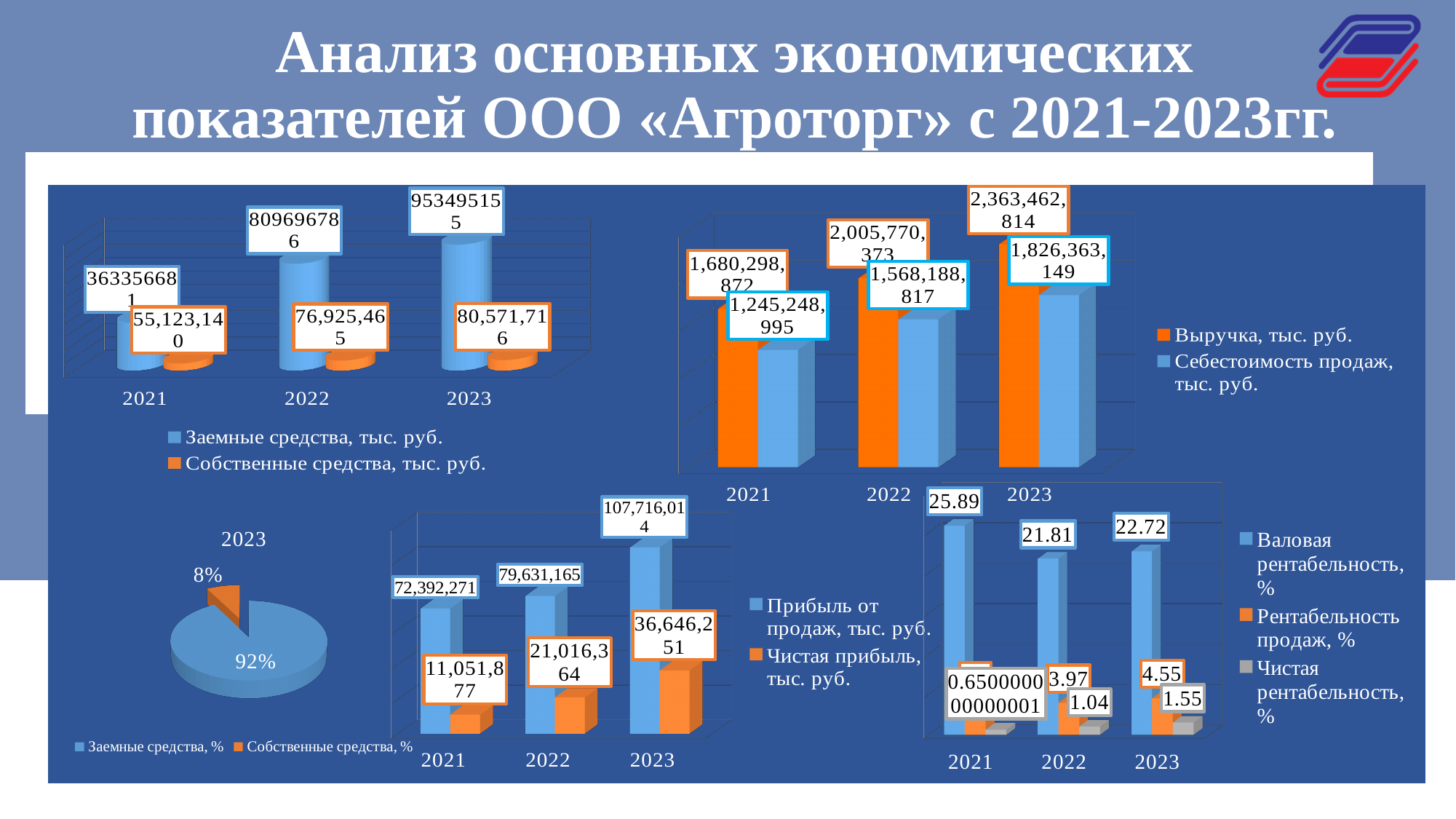
In the bottom-right chart, what is the value of Валовая рентабельность, % for 2021? 25.89 In the top-left chart, what is the value of Собственные средства, тыс. руб. for 2022? 76,925,465 In the bottom-middle chart, which year has the lowest Прибыль от продаж, тыс. руб.? 2021 In the top-right chart, which year has the highest Выручка, тыс. руб.? 2023 In the top-right chart, does Выручка, тыс. руб. rise or fall from 2021 to 2023? rise In the top-right chart, what is the value of Себестоимость продаж, тыс. руб. for 2021? 1,245,248,995 In the bottom-right chart, what is the value of Чистая рентабельность, % for 2023? 1.55 In the top-left chart, what is the value of Заемные средства, тыс. руб. for 2023? 953495155 In the bottom-middle chart, what is the value of Чистая прибыль, тыс. руб. for 2022? 21,016,364 In the top-right chart, what is the value of Выручка, тыс. руб. for 2023? 2,363,462,814 How many series does the legend of the bottom-right chart list? 3 In the bottom-left pie chart, what share does Заемные средства, % have? 92%